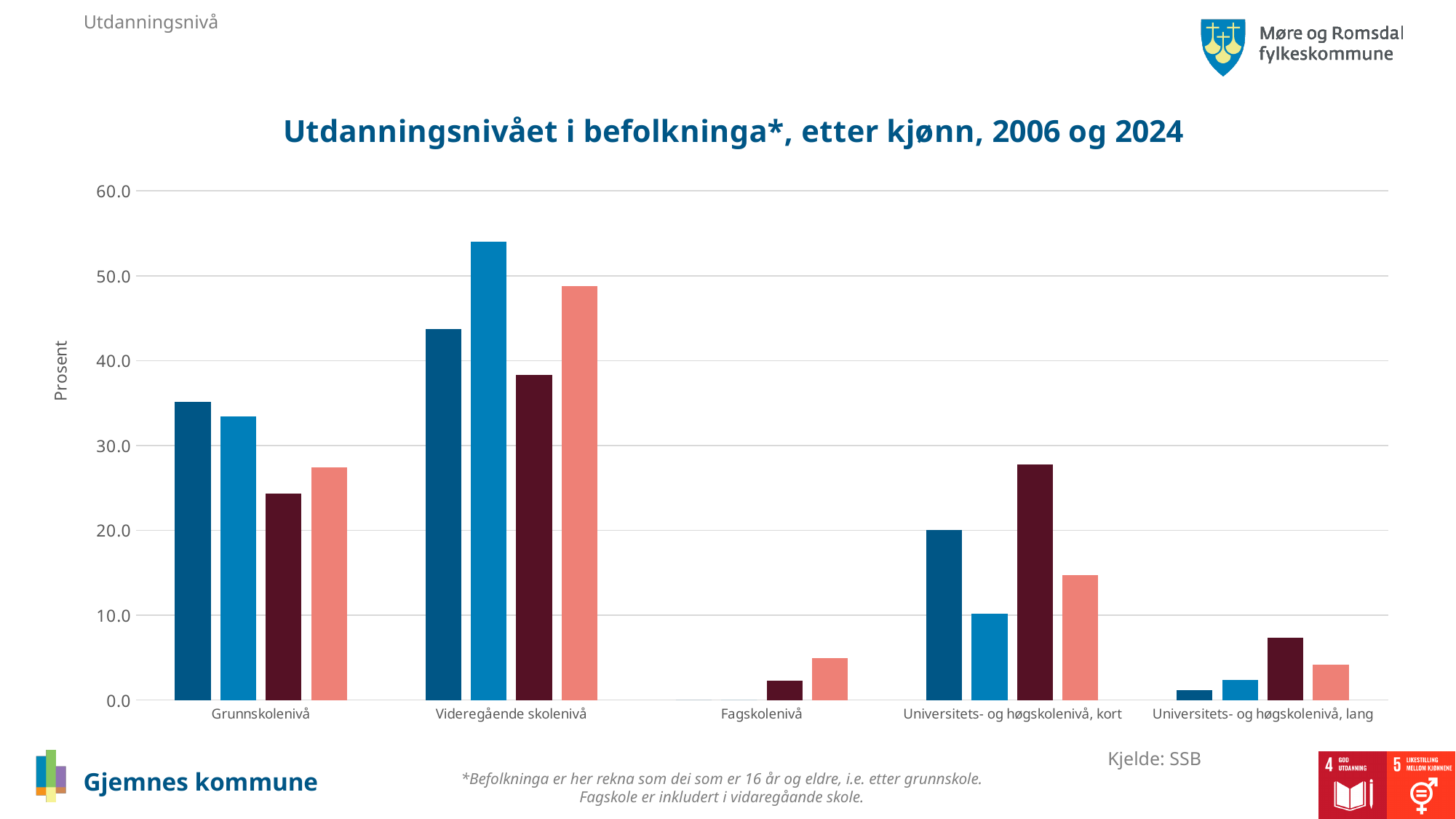
Is the tallest bar for Universitets- og høgskolenivå, kort greater or less than 30? less What is the label on the y axis? Prosent Is the tallest bar for Grunnskolenivå greater or less than 30? greater Is the tallest bar for Videregående skolenivå greater or less than 50? greater Which category contains the tallest bar in the chart? Videregående skolenivå How many education-level categories are shown on the x axis? 5 What is the title of the chart? Utdanningsnivået i befolkninga*, etter kjønn, 2006 og 2024 What kind of chart is shown on the slide? bar chart Which category has the lowest bars overall? Fagskolenivå Which category has the taller tallest bar, Grunnskolenivå or Universitets- og høgskolenivå, kort? Grunnskolenivå